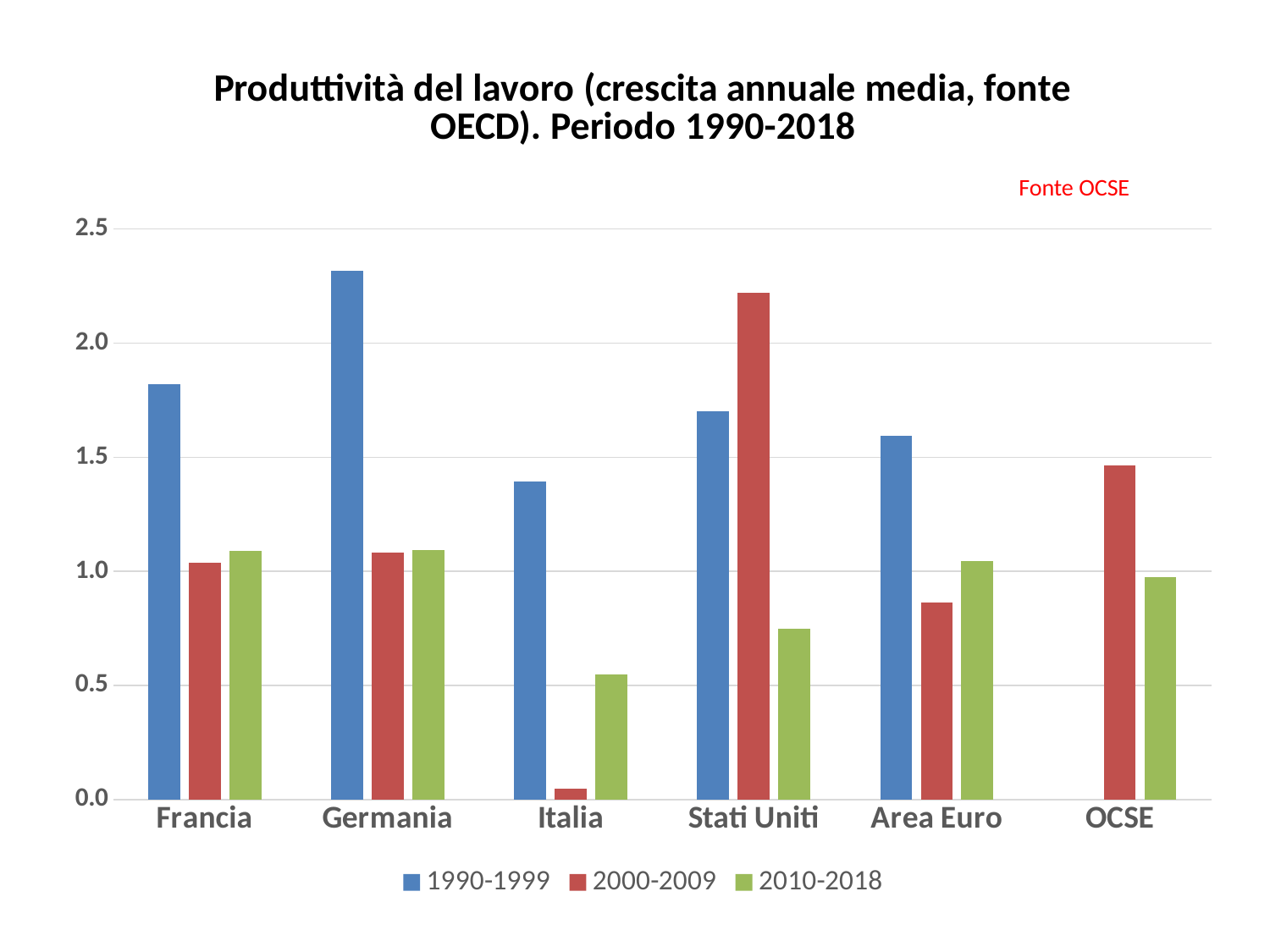
How many series does the legend list? 3 Which category has no bar for the 1990-1999 series? OCSE Which category has the highest value for the 2000-2009 series? Stati Uniti Which category has the lowest value for the 2000-2009 series? Italia Is the 1990-1999 value for Germania greater or less than 2.0? greater Which is larger: the 1990-1999 value for Italia or the 1990-1999 value for Area Euro? Area Euro Which category has the lowest value for the 2010-2018 series? Italia Which category has the highest value for the 1990-1999 series? Germania What kind of chart is shown on the slide? bar chart Is the 2000-2009 value for Area Euro greater or less than 1.0? less For Stati Uniti, which series has the larger value: 1990-1999 or 2000-2009? 2000-2009 How many categories are shown on the x axis? 6